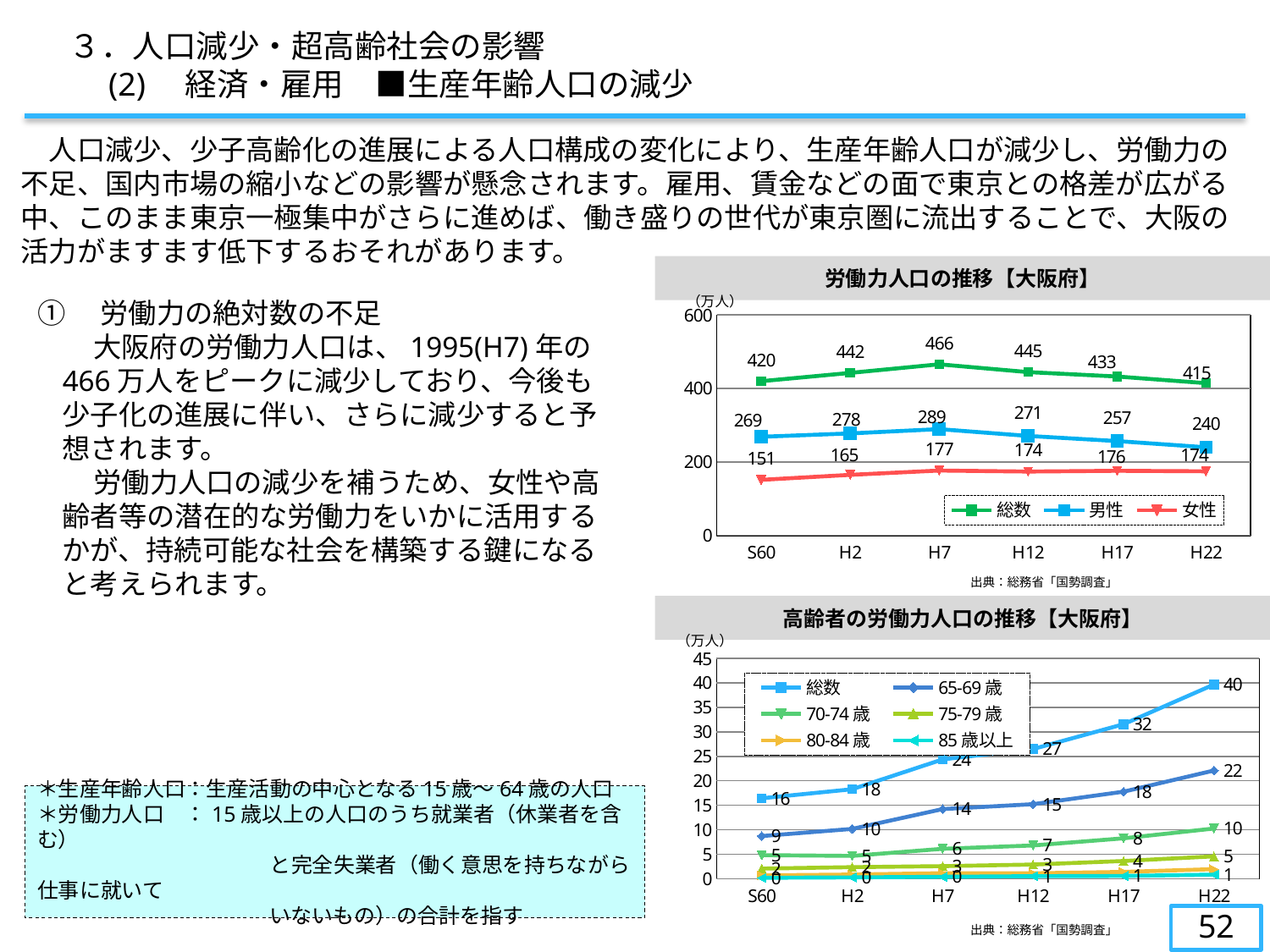
In the chart titled 高齢者の労働力人口の推移【大阪府】, what is the value of 総数 at H22? 40 In the chart titled 労働力人口の推移【大阪府】, what is the difference between 男性 and 女性 at H7? 112 In the chart titled 高齢者の労働力人口の推移【大阪府】, how many years are shown on the x axis? 6 In the chart titled 労働力人口の推移【大阪府】, how many series does the legend list? 3 In the chart titled 労働力人口の推移【大阪府】, what is the value of 男性 at H22? 240 In the chart titled 労働力人口の推移【大阪府】, at which year is 総数 highest? H7 What kind of chart is 高齢者の労働力人口の推移【大阪府】? line chart In the chart titled 労働力人口の推移【大阪府】, does 男性 rise or fall from H7 to H22? fall In the chart titled 高齢者の労働力人口の推移【大阪府】, what is the value of 65-69歳 at H12? 15 In the chart titled 労働力人口の推移【大阪府】, what is the value of 女性 at S60? 151 In the chart titled 高齢者の労働力人口の推移【大阪府】, how many series does the legend list? 6 In the chart titled 労働力人口の推移【大阪府】, what is the value of 総数 at H7? 466